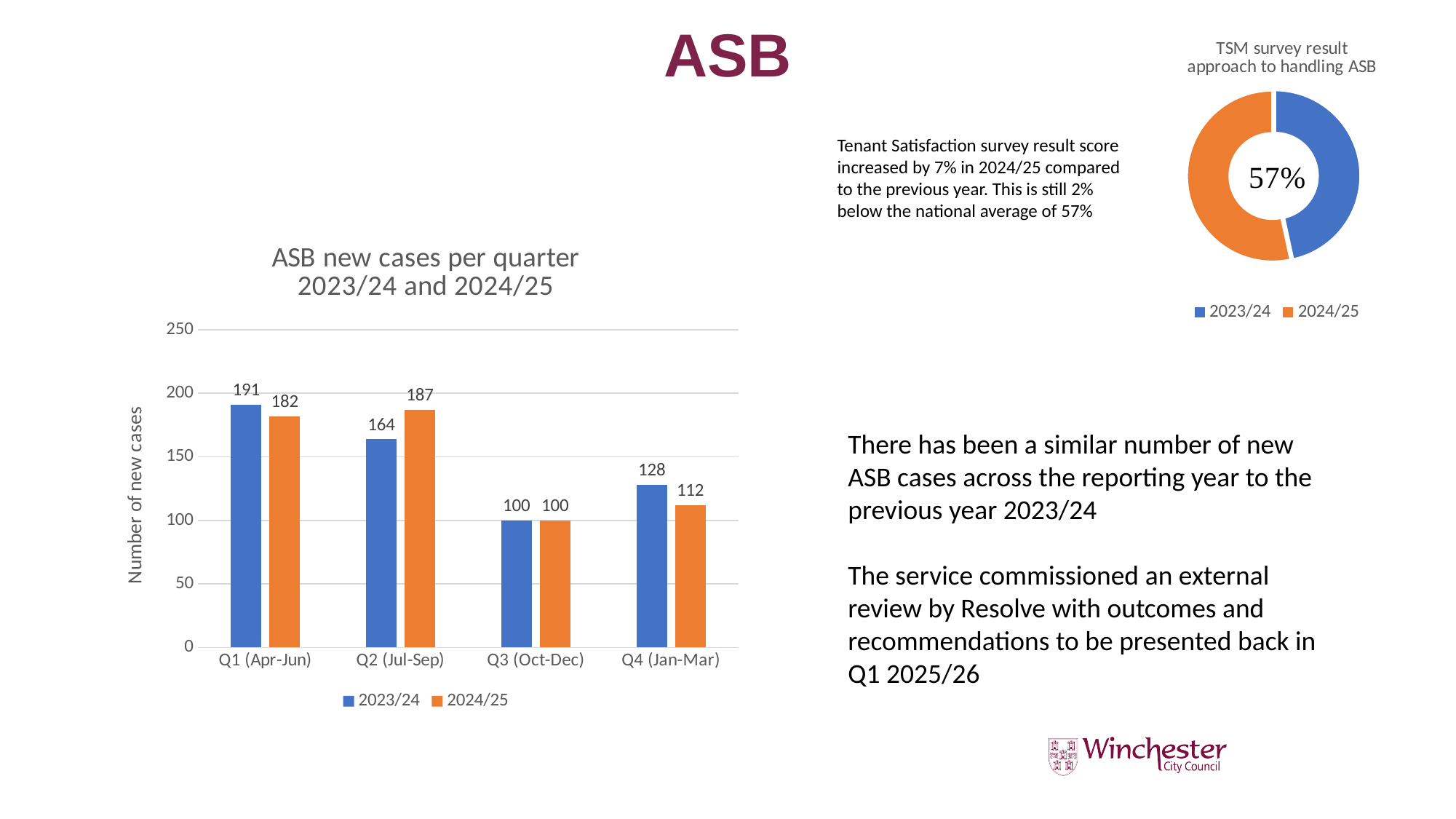
In the 'ASB new cases per quarter' chart, how many new cases were there in Q2 (Jul-Sep) for 2024/25? 187 In the 'ASB new cases per quarter' chart, is the 2023/24 value for Q2 (Jul-Sep) greater or less than 150? greater In the 'ASB new cases per quarter' chart, which is larger for Q4 (Jan-Mar): 2023/24 or 2024/25? 2023/24 How many series does the legend of the 'ASB new cases per quarter' chart list? 2 In the 'ASB new cases per quarter' chart, how many new cases were there in Q1 (Apr-Jun) for 2023/24? 191 In the 'ASB new cases per quarter' chart, which quarter has the highest number of new cases for 2023/24? Q1 (Apr-Jun) In the 'ASB new cases per quarter' chart, what is the 2024/25 value for Q4 (Jan-Mar)? 112 In the 'ASB new cases per quarter' chart, what is the difference between the 2023/24 and 2024/25 values for Q2 (Jul-Sep)? 23 How many quarters are shown on the x axis of the 'ASB new cases per quarter' chart? 4 In the 'ASB new cases per quarter' chart, which quarter has the lowest number of new cases for 2024/25? Q3 (Oct-Dec) What kind of chart is the 'ASB new cases per quarter' chart? Bar chart What kind of chart is the 'TSM survey result approach to handling ASB' chart in the top right? Doughnut chart